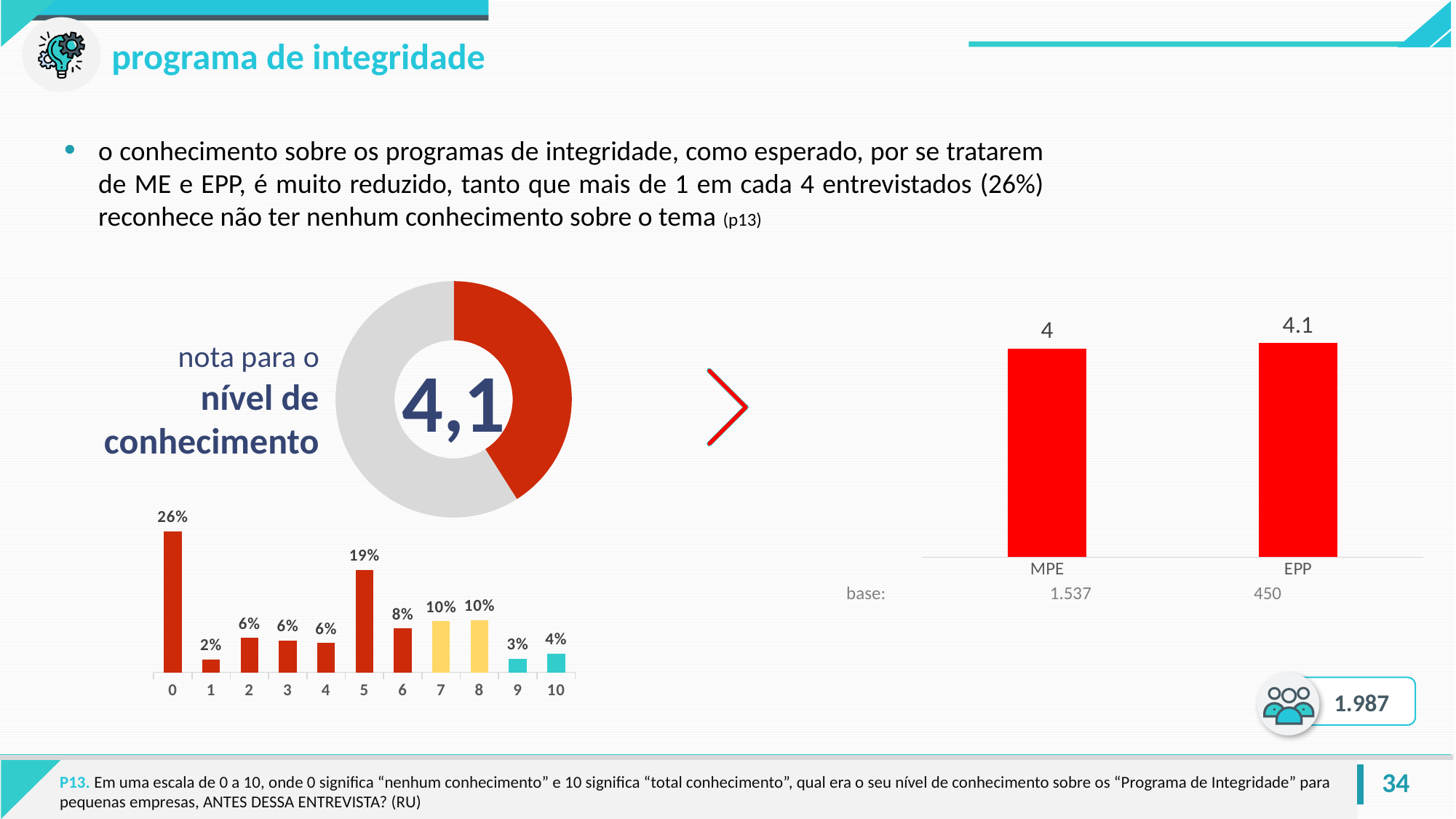
What kind of chart is the one on the right comparing MPE and EPP? bar chart In the bar chart of scores 0 to 10 at the bottom left, which score has the lowest percentage? 1 In the bar chart of scores 0 to 10 at the bottom left, what percentage is shown for score 5? 19% In the bar chart of scores 0 to 10 at the bottom left, what is the difference between the percentages for score 0 and score 5? 7% How many score categories are shown in the bar chart of scores 0 to 10 at the bottom left? 11 In the bar chart on the right comparing MPE and EPP, what is the base shown for EPP? 450 In the bar chart of scores 0 to 10 at the bottom left, what percentage is shown for score 0? 26% In the bar chart on the right comparing MPE and EPP, what is the value for MPE? 4 In the bar chart of scores 0 to 10 at the bottom left, which is larger: the percentage for score 6 or for score 9? score 6 In the bar chart of scores 0 to 10 at the bottom left, which score has the highest percentage? 0 What value is displayed in the centre of the donut chart labelled 'nota para o nível de conhecimento'? 4,1 In the bar chart on the right comparing MPE and EPP, what is the value for EPP? 4.1